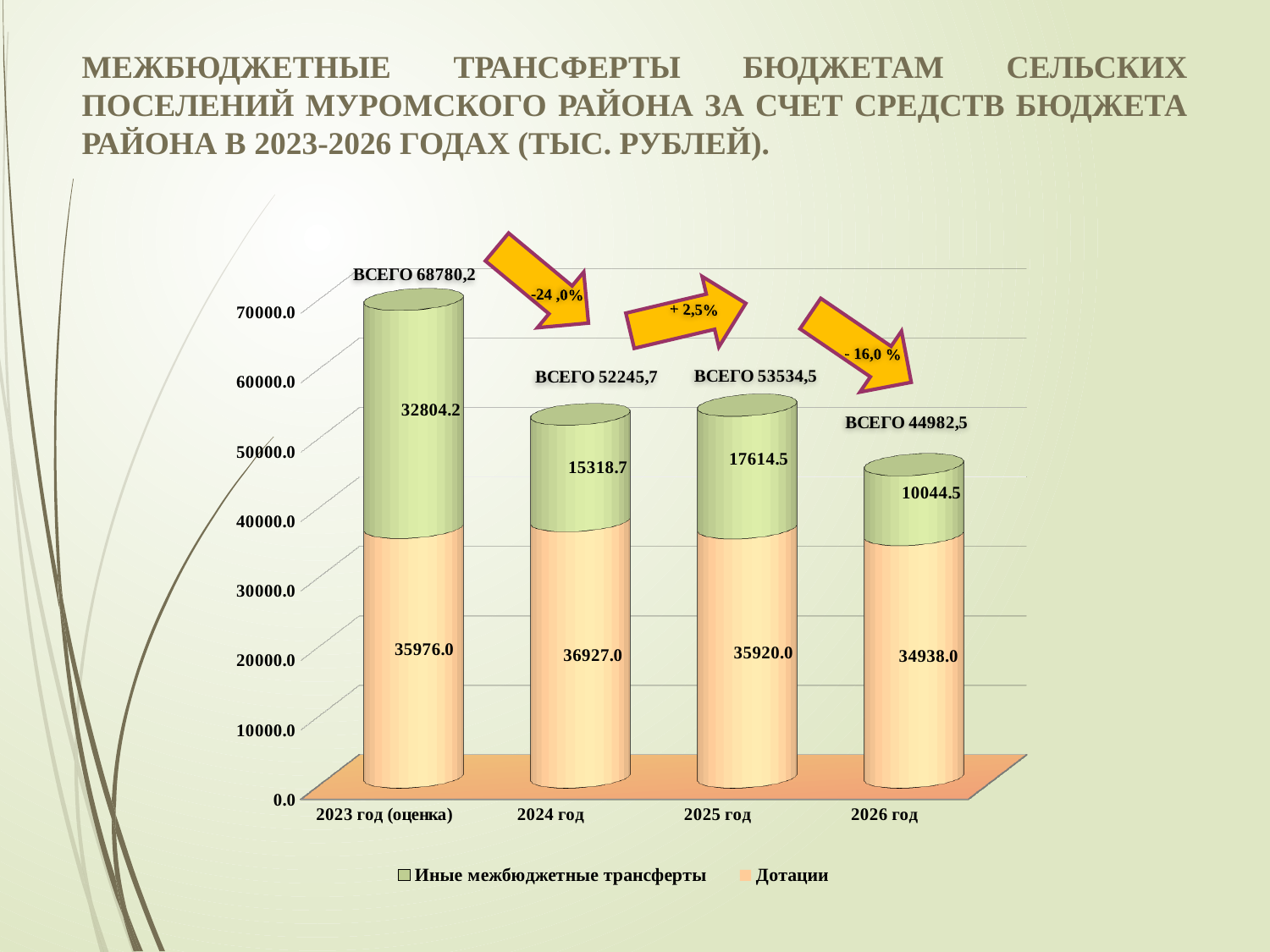
What is the value of Дотации for 2024 год? 36927.0 What type of chart is shown on the slide? stacked bar chart What is the value of Иные межбюджетные трансферты for 2023 год (оценка)? 32804.2 What percentage change is shown by the arrow between 2023 год (оценка) and 2024 год? -24 ,0% Which is larger: Дотации in 2024 год or Дотации in 2025 год? 2024 год Which year has the lowest value of Дотации? 2026 год What is the difference between Иные межбюджетные трансферты in 2025 год and 2024 год? 2295.8 How many series does the legend list? 2 What is the total (ВСЕГО) shown for 2026 год? 44982,5 What is the value of Иные межбюджетные трансферты for 2025 год? 17614.5 How many year categories are shown on the x axis? 4 Which year has the highest value of Иные межбюджетные трансферты? 2023 год (оценка)